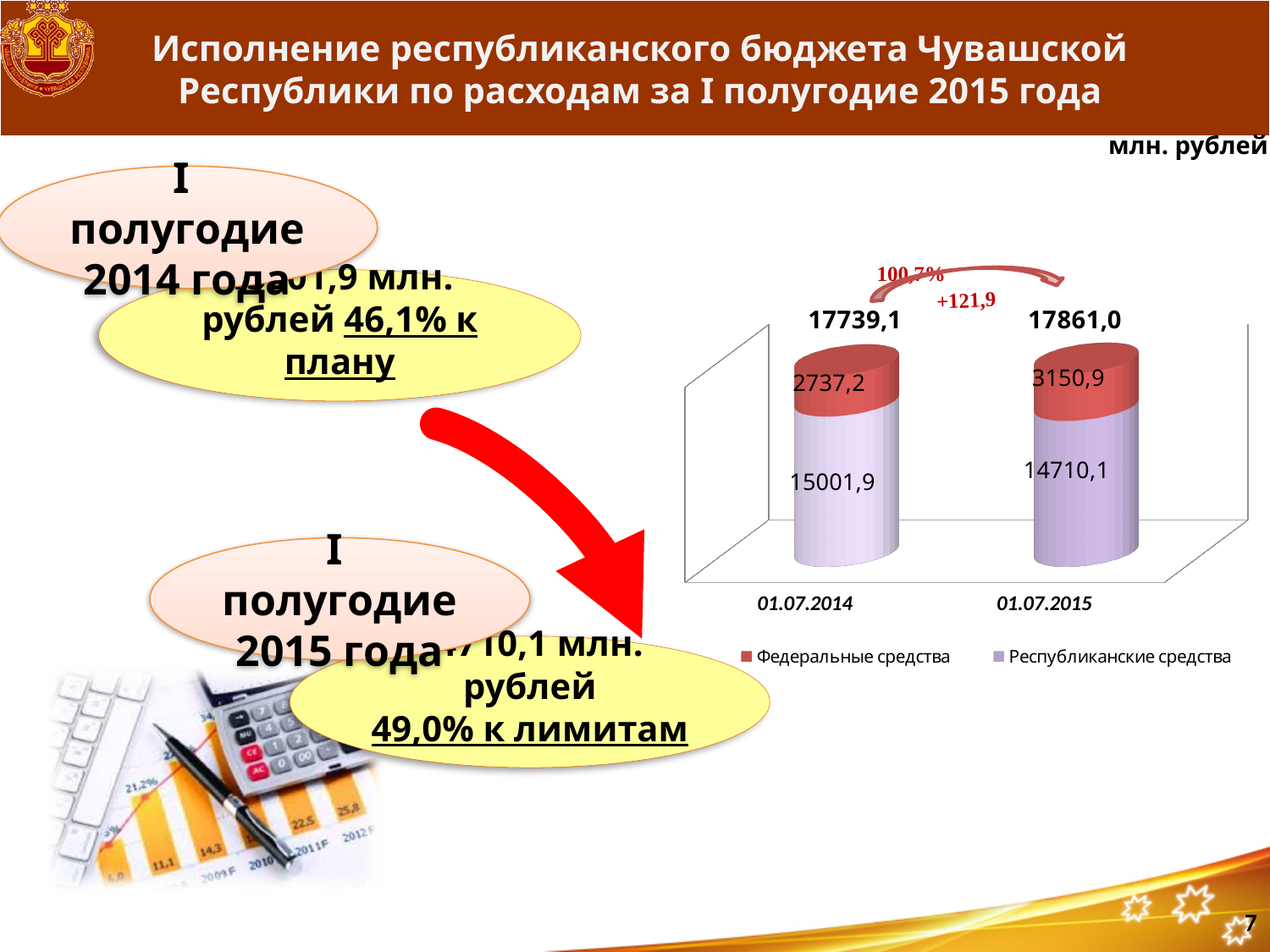
How many series does the chart legend list? 2 What type of chart is shown on the slide? bar chart What is the value of Республиканские средства for 01.07.2014? 15001,9 What is the value of Федеральные средства for 01.07.2015? 3150,9 How many categories are shown on the x axis of the chart? 2 What is the value of Республиканские средства for 01.07.2015? 14710,1 Which date has the higher value for Федеральные средства, 01.07.2014 or 01.07.2015? 01.07.2015 Which series is shown in red in the chart? Федеральные средства What is the total of the stacked bar for 01.07.2014? 17739,1 What is the value of Федеральные средства for 01.07.2014? 2737,2 What is the total of the stacked bar for 01.07.2015? 17861,0 What is the difference between the Республиканские средства values for 01.07.2014 and 01.07.2015? 291,8